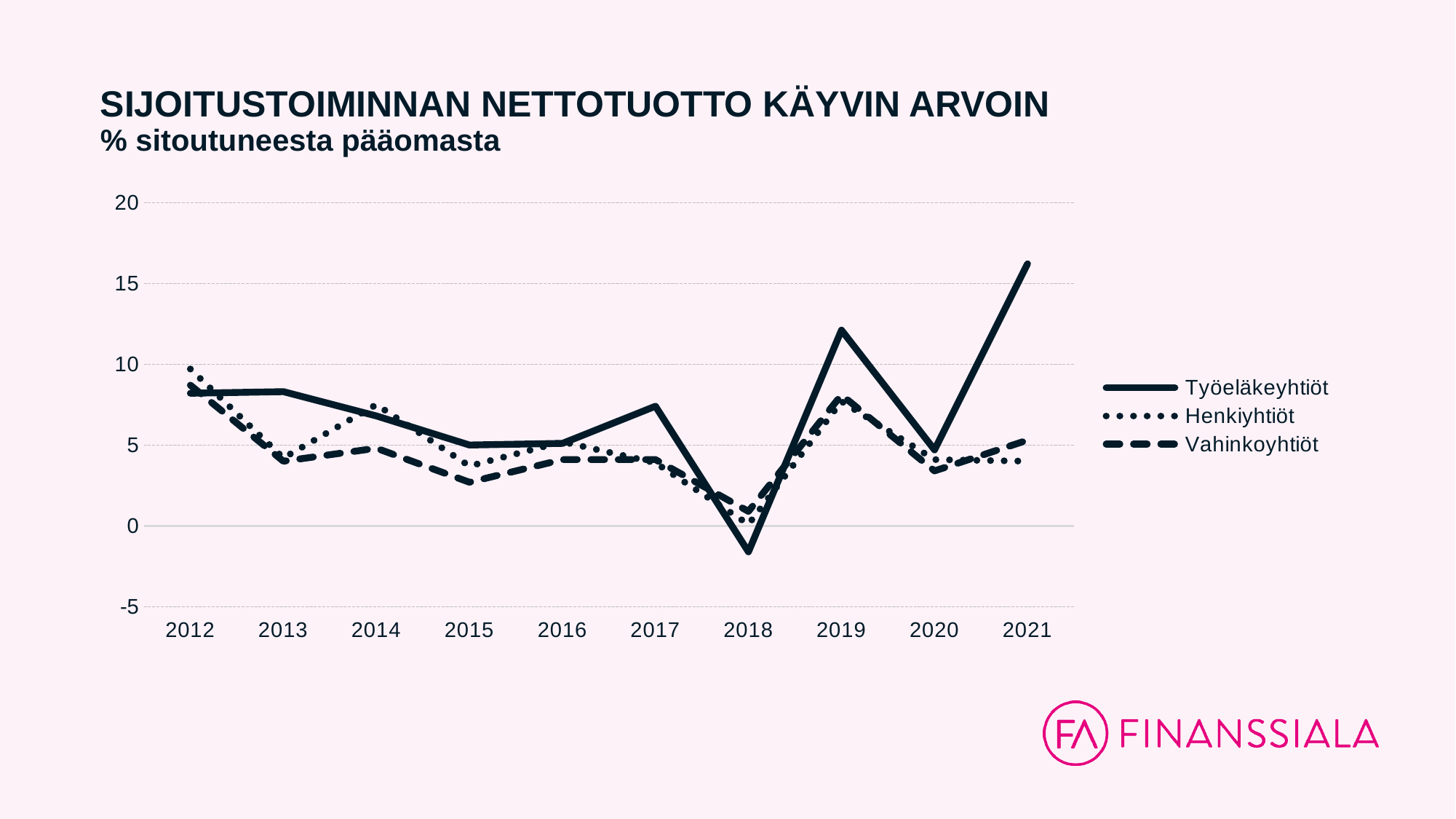
How many series does the legend list? 3 Is the value for Työeläkeyhtiöt in 2018 greater or less than 0? less How many years are plotted along the x axis? 10 Does the Työeläkeyhtiöt series rise or fall from 2018 to 2019? rise Is the value for Vahinkoyhtiöt in 2015 greater or less than 5? less In which year does the Työeläkeyhtiöt series reach its highest value? 2021 In 2019, which series has the higher value, Työeläkeyhtiöt or Vahinkoyhtiöt? Työeläkeyhtiöt In which year does the Henkiyhtiöt series reach its lowest value? 2018 Is the value for Työeläkeyhtiöt in 2021 greater or less than 15? greater In which year does the Työeläkeyhtiöt series reach its lowest value? 2018 Which series is drawn with a solid line in the legend? Työeläkeyhtiöt What kind of chart is shown on the slide? line chart